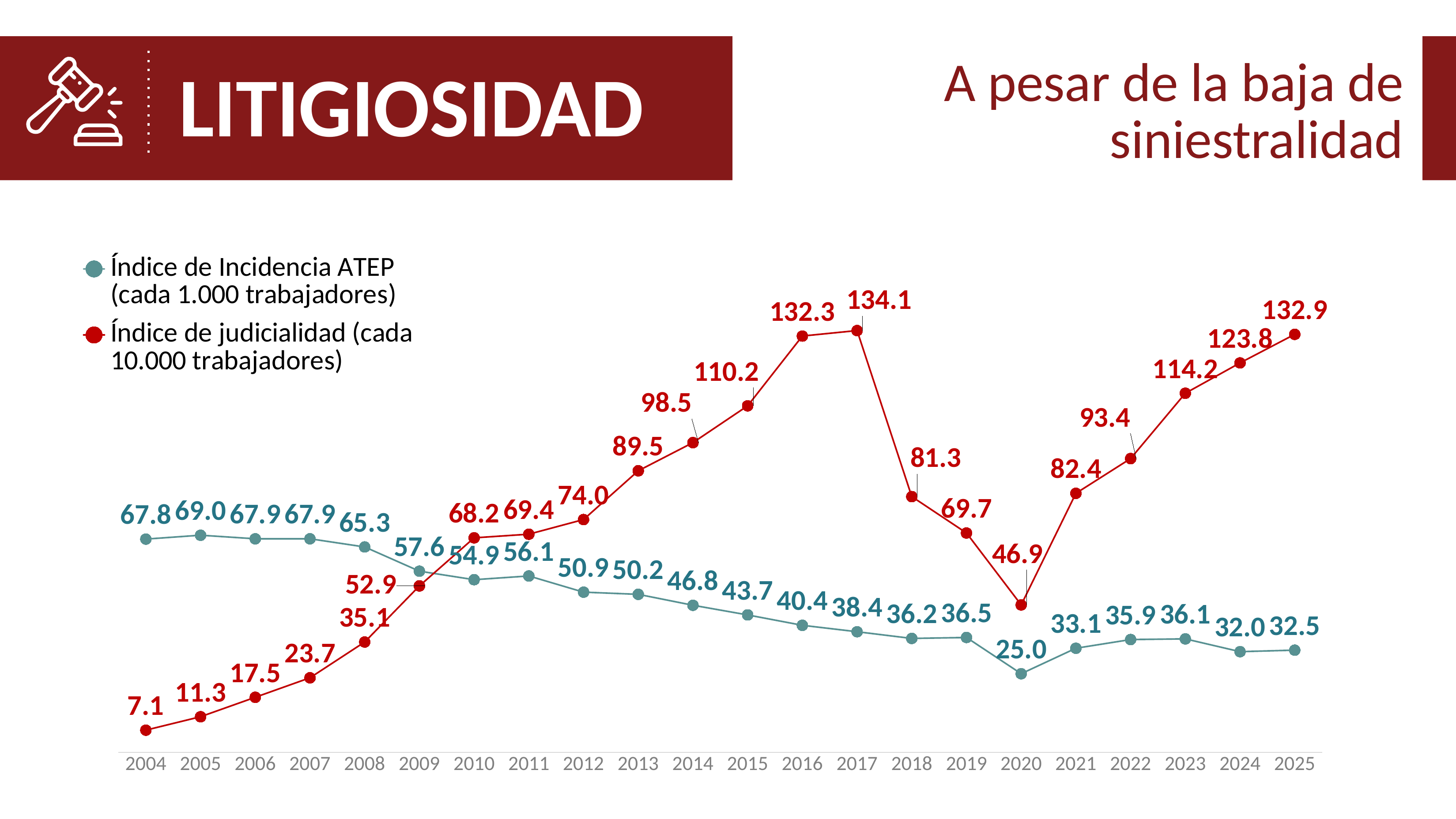
Does the Índice de Incidencia ATEP generally rise or fall from 2004 to 2025? Fall In which year is the Índice de Incidencia ATEP at its lowest? 2020 What is the difference between the Índice de judicialidad in 2017 and in 2018? 52.8 How many series does the legend list? 2 What colour is the line for the Índice de judicialidad? Red In which year does the Índice de judicialidad reach its highest value? 2017 What is the value of the Índice de judicialidad in 2004? 7.1 Which is larger in 2009: the Índice de Incidencia ATEP or the Índice de judicialidad? Índice de Incidencia ATEP How many years are shown on the x axis? 22 What kind of chart is shown on the slide? Line chart What is the value of the Índice de judicialidad in 2017? 134.1 What is the value of the Índice de Incidencia ATEP in 2020? 25.0